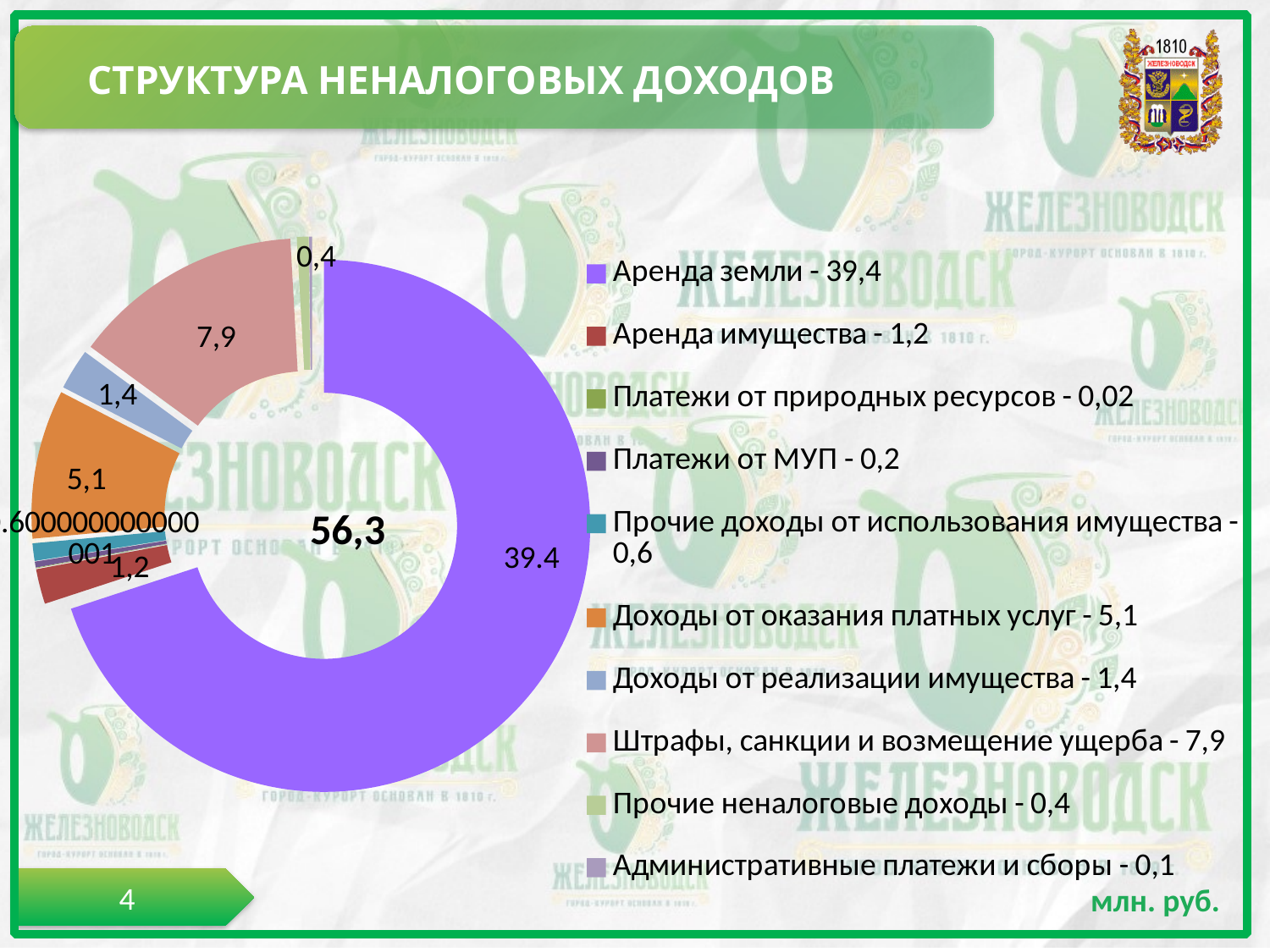
What is the value for Платежи от природных ресурсов? 0,02 What total value is shown in the centre of the chart? 56,3 What kind of chart is shown on the slide? doughnut chart What is the value for Аренда земли? 39,4 What is the title of the chart on the slide? СТРУКТУРА НЕНАЛОГОВЫХ ДОХОДОВ What is the difference between the values for Аренда земли and Штрафы, санкции и возмещение ущерба? 31,5 How many categories does the legend of the chart list? 10 What is the value for Доходы от оказания платных услуг? 5,1 What is the value for Штрафы, санкции и возмещение ущерба? 7,9 Which category has the largest value? Аренда земли Which category has the smallest value? Платежи от природных ресурсов Which is larger: Аренда имущества or Доходы от реализации имущества? Доходы от реализации имущества